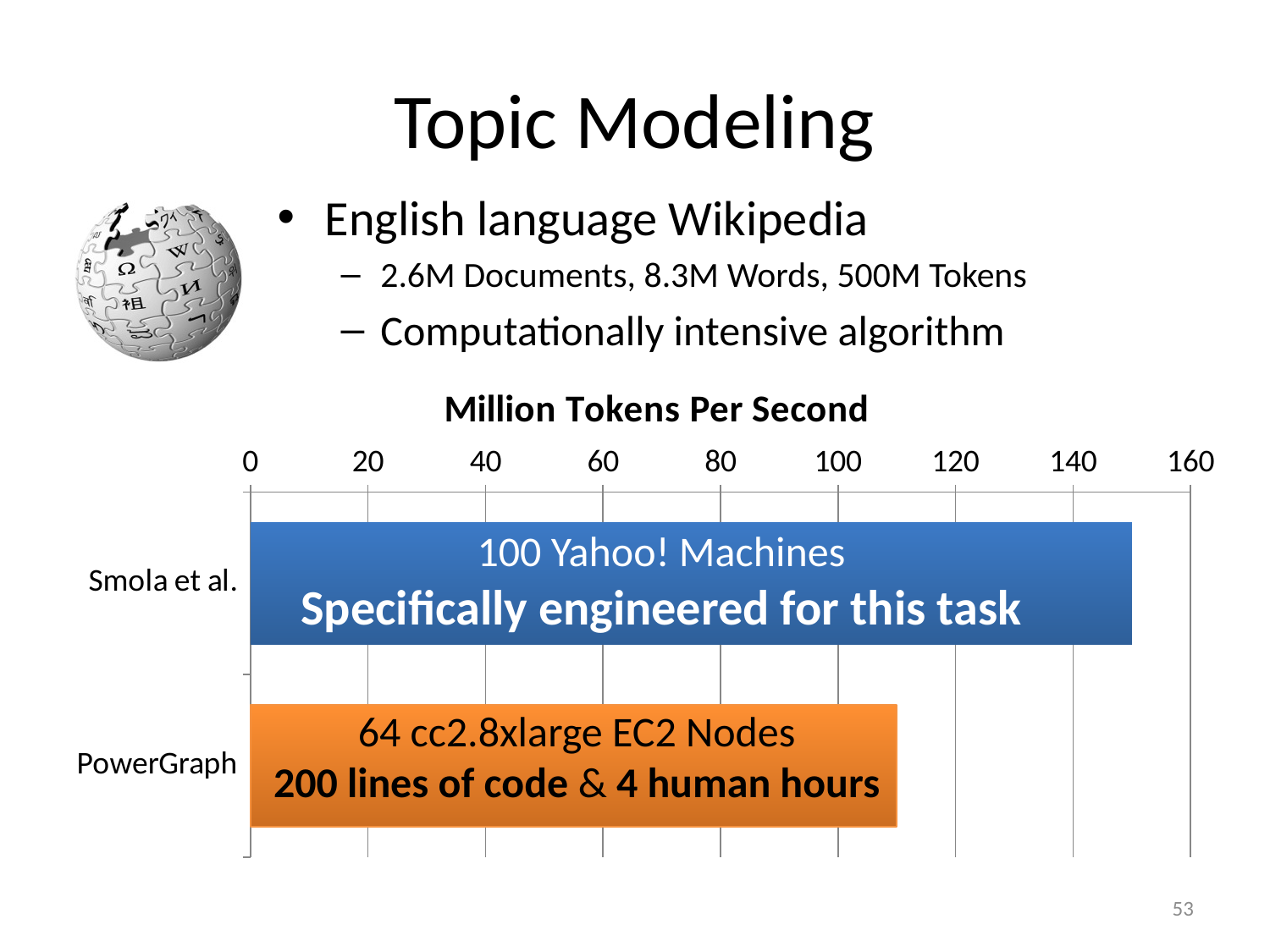
What kind of chart is shown on the slide? bar chart Is the value for PowerGraph greater or less than 120? less What is the maximum value shown on the chart's horizontal axis? 160 What is the title of the chart? Million Tokens Per Second How many categories (bars) does the chart show? 2 Which has a larger value, Smola et al. or PowerGraph? Smola et al. Is the value for PowerGraph greater or less than 100? greater Which category has the highest value in the chart? Smola et al. Is the value for Smola et al. greater or less than 140? greater Which category has the lowest value in the chart? PowerGraph